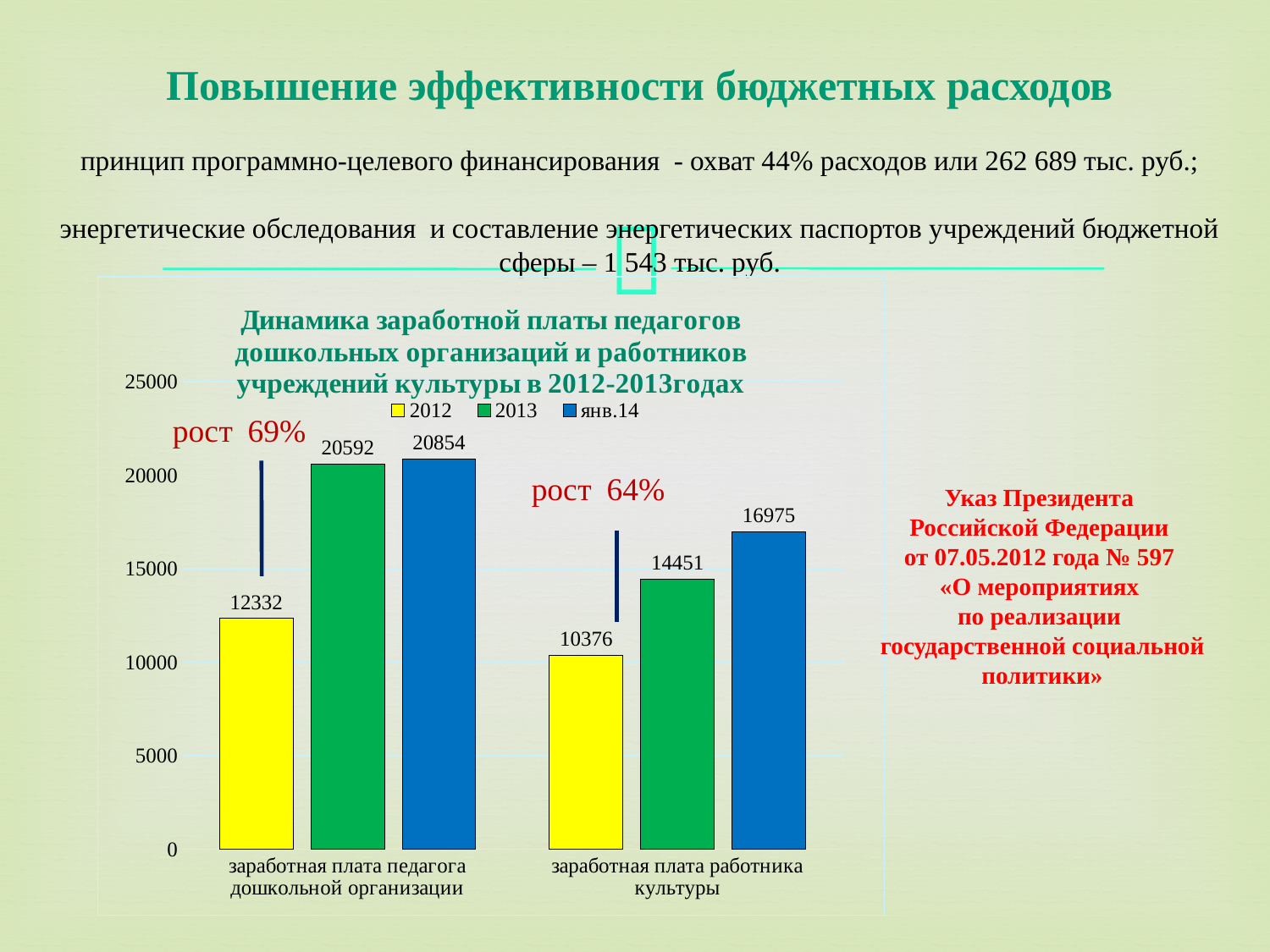
How many series does the legend list? 3 Which series has the highest value for заработная плата работника культуры? янв.14 What was the 2013 salary of a culture worker (заработная плата работника культуры)? 14451 What is the difference between the янв.14 and 2013 values for заработная плата работника культуры? 2524 What colour are the 2012 bars in the chart? yellow Which is larger: the 2013 value for заработная плата педагога дошкольной организации or the янв.14 value for заработная плата работника культуры? 2013 value for заработная плата педагога дошкольной организации What is the difference between the 2013 and 2012 values for заработная плата педагога дошкольной организации? 8260 What kind of chart is shown on the slide? bar chart What was the 2012 salary of a preschool teacher (заработная плата педагога дошкольной организации)? 12332 What is the 2012 value for заработная плата работника культуры? 10376 What is the янв.14 value for заработная плата педагога дошкольной организации? 20854 Which series has the lowest value for заработная плата педагога дошкольной организации? 2012